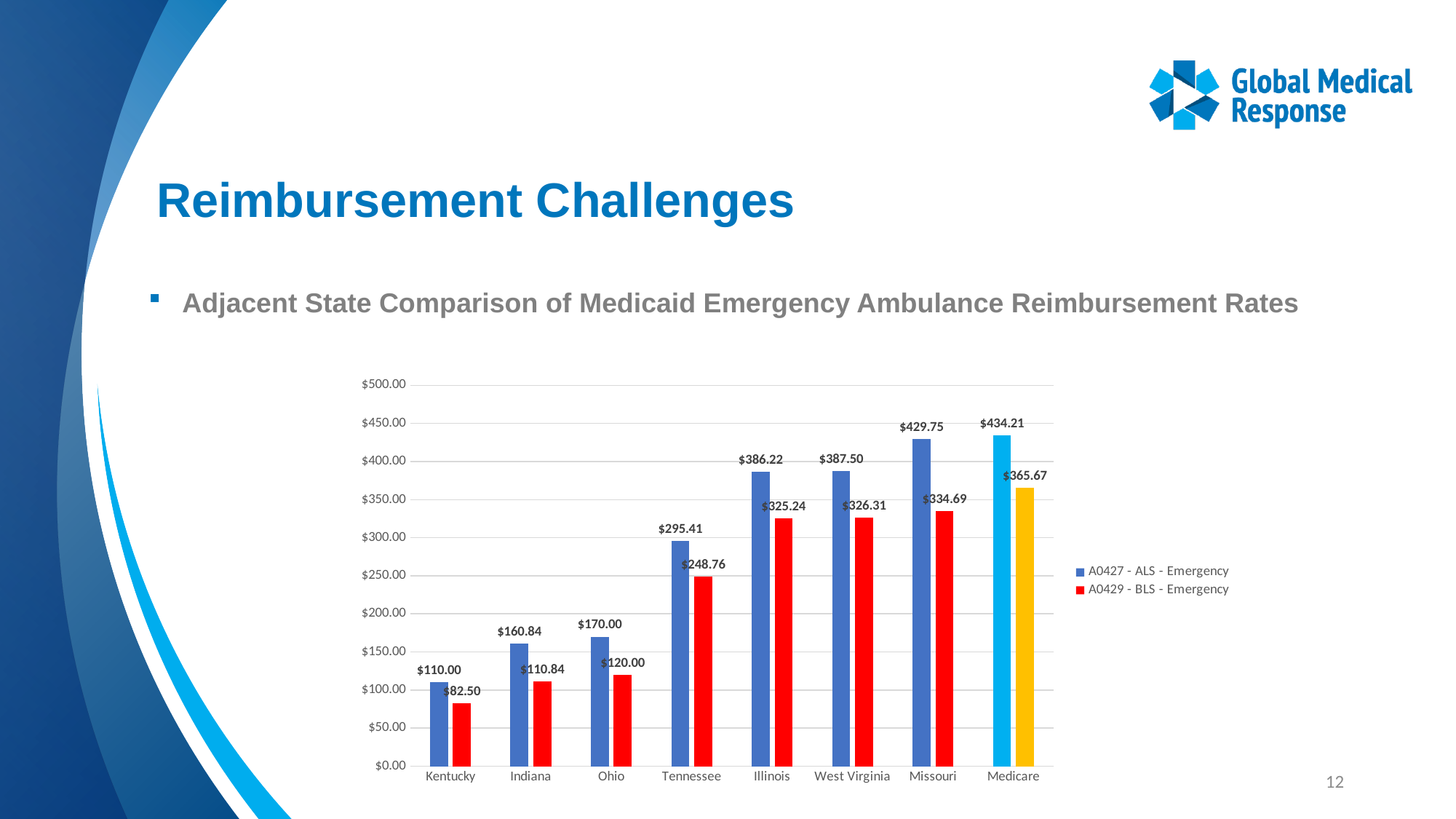
What is the difference between the A0427 - ALS - Emergency and A0429 - BLS - Emergency values for Ohio? $50.00 How many categories are shown on the x axis? 8 What is the A0429 - BLS - Emergency value for Kentucky? $82.50 What kind of chart is shown on the slide? Bar chart Which is larger, the A0429 - BLS - Emergency value for Indiana or for Ohio? Ohio Which category has the highest A0427 - ALS - Emergency value? Medicare Do the A0427 - ALS - Emergency values rise or fall from Kentucky to Medicare along the x axis? Rise What is the difference between the A0427 - ALS - Emergency values for Medicare and Kentucky? $324.21 What is the A0427 - ALS - Emergency value for Tennessee? $295.41 Which category has the lowest A0429 - BLS - Emergency value? Kentucky What is the A0429 - BLS - Emergency value for Missouri? $334.69 How many series does the legend list? 2